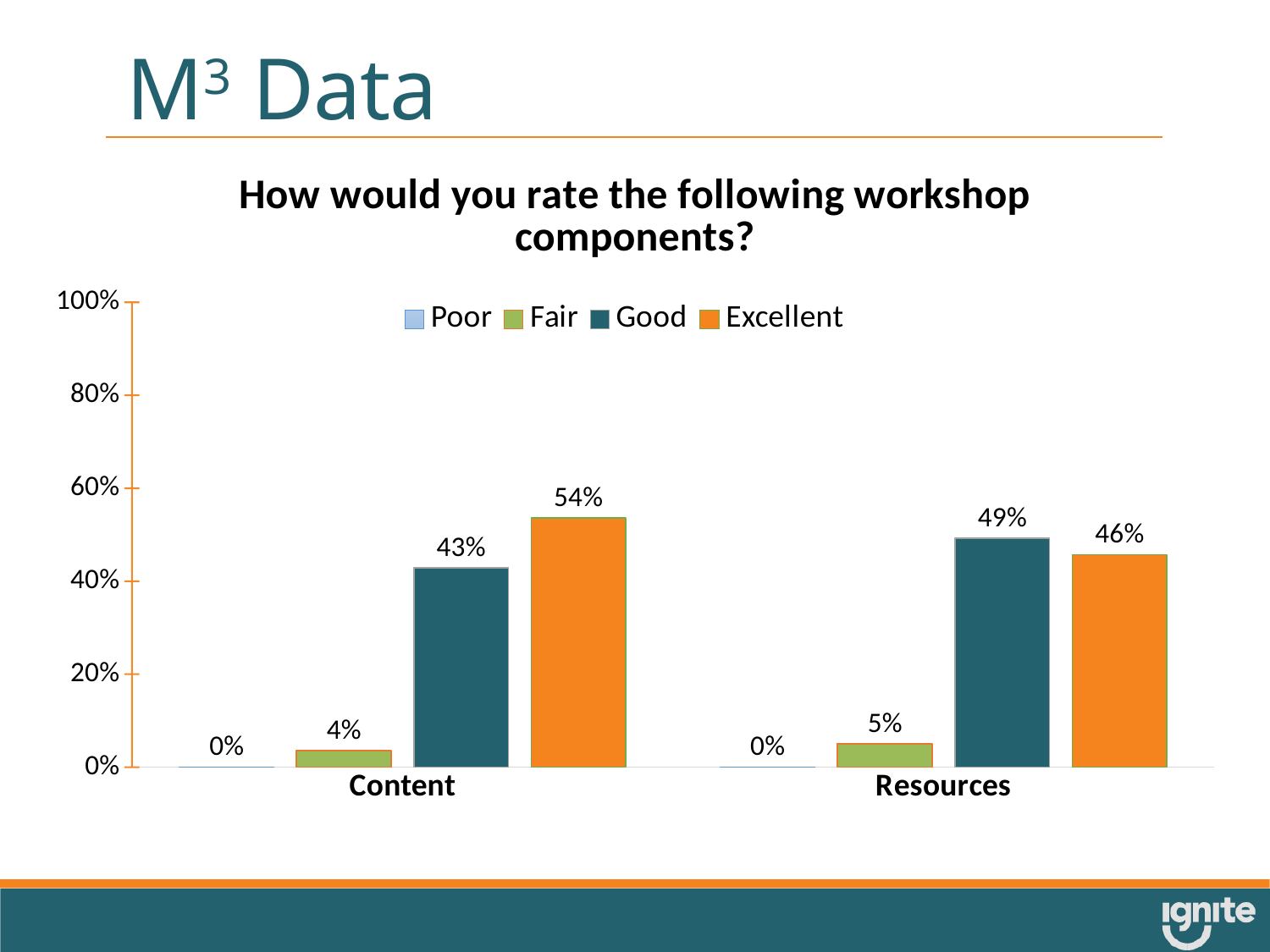
What kind of chart is shown on the slide? Bar chart Which is larger for Resources: the Good percentage or the Excellent percentage? Good What percentage rated the Resources component as Good? 49% How many workshop components are shown on the x axis? 2 What is the difference between the Excellent percentages for Content and Resources? 8% How many series does the legend list? 4 Which rating received the highest percentage for Content? Excellent What percentage rated the Resources component as Fair? 5% What percentage rated the Content component as Excellent? 54% What percentage rated the Content component as Poor? 0% Which rating received the lowest percentage for Resources? Poor What is the title of the chart? How would you rate the following workshop components?